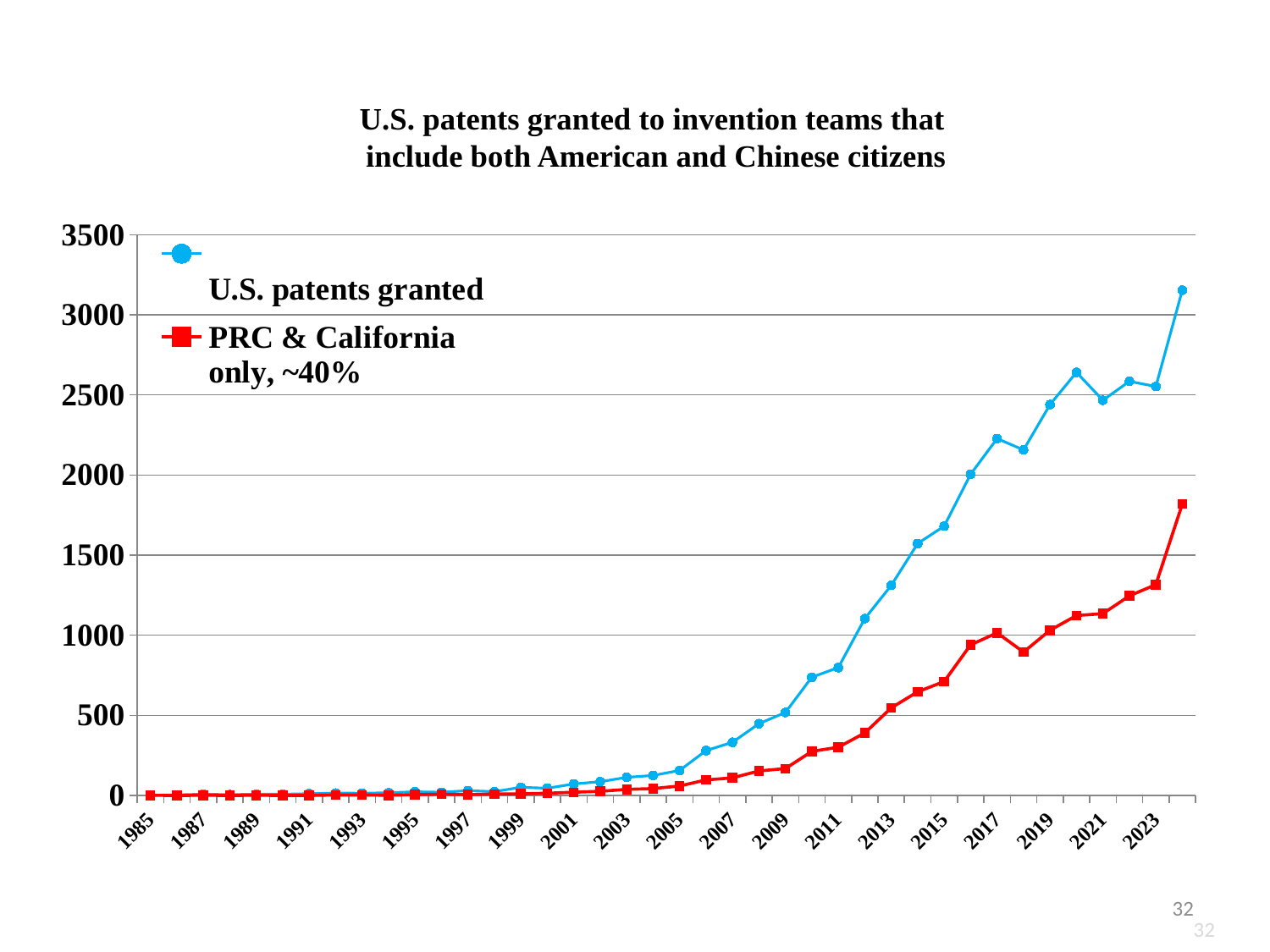
How many year labels are shown on the x axis? 20 Is the value for U.S. patents granted in 2015 greater or less than 1500? greater What kind of chart is shown on the slide? line chart Do the values for U.S. patents granted generally rise or fall from 1985 to the end of the series? rise In 2017, which series has the larger value: U.S. patents granted or PRC & California only? U.S. patents granted Is the value for U.S. patents granted in 2017 greater or less than 2000? greater Is the value for U.S. patents granted in 2011 greater or less than 500? greater How many series does the legend list? 2 Which series is drawn with red square markers? PRC & California only, ~40% What is the title of the chart? U.S. patents granted to invention teams that include both American and Chinese citizens